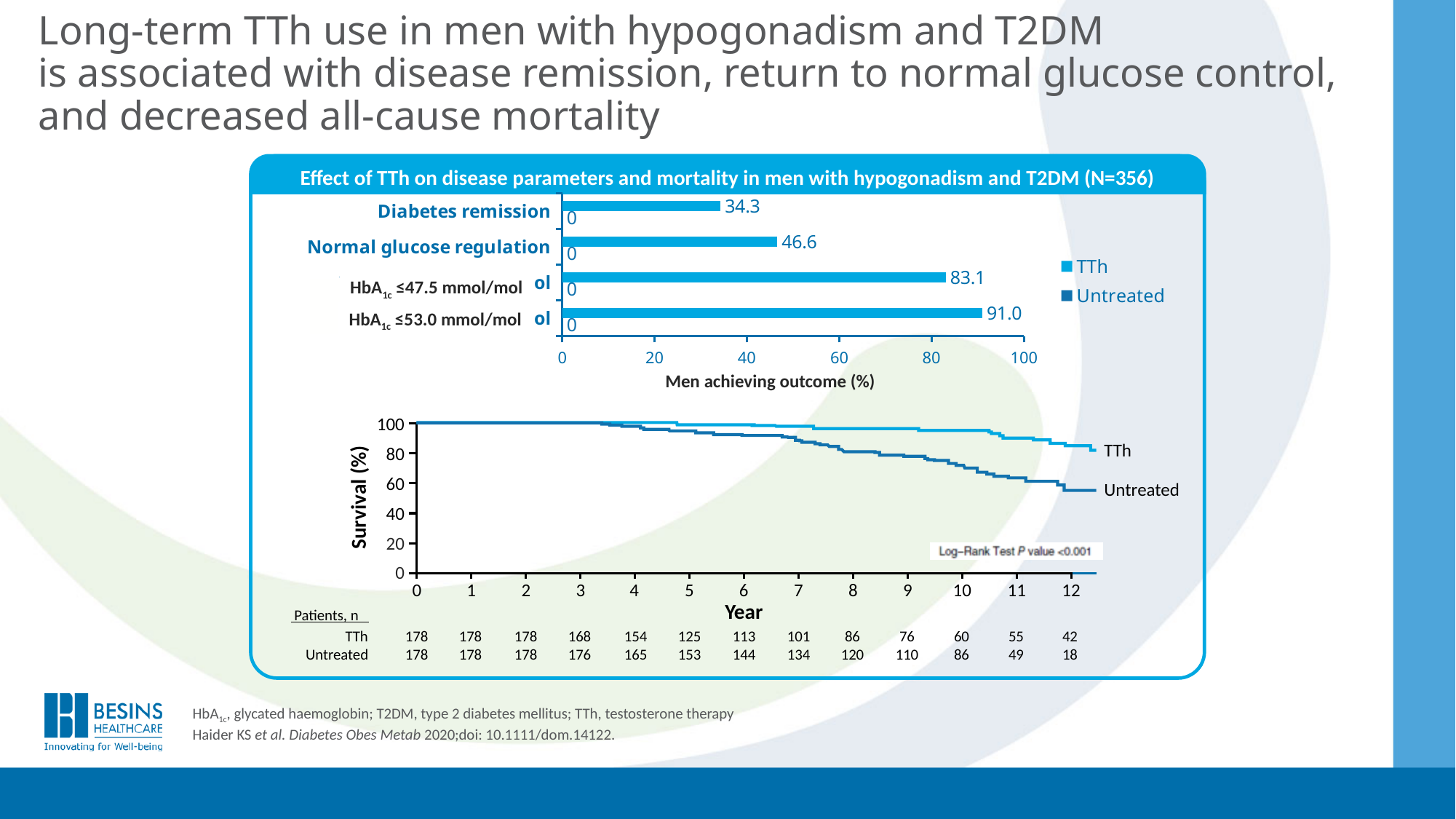
In the top bar chart, how many series does the legend list? 2 In the top bar chart, what is the TTh value for normal glucose regulation? 46.6 In the top bar chart, which outcome has the highest TTh value? HbA1c ≤53.0 mmol/mol In the top bar chart, what is the TTh value for HbA1c ≤53.0 mmol/mol? 91.0 In the bottom survival chart, which group has the higher survival at year 12, TTh or Untreated? TTh In the top bar chart, what is the difference between the TTh values for HbA1c ≤53.0 mmol/mol and HbA1c ≤47.5 mmol/mol? 7.9 In the top bar chart, what is the Untreated value for HbA1c ≤47.5 mmol/mol? 0 What kind of chart is the top chart on the slide? Bar chart In the top bar chart, what percentage of TTh-treated men achieved diabetes remission? 34.3 In the top bar chart, which outcome has the lowest TTh value? Diabetes remission In the bottom survival chart, how many TTh patients are listed at year 12? 42 In the bottom survival chart, how many Untreated patients are listed at year 10? 86